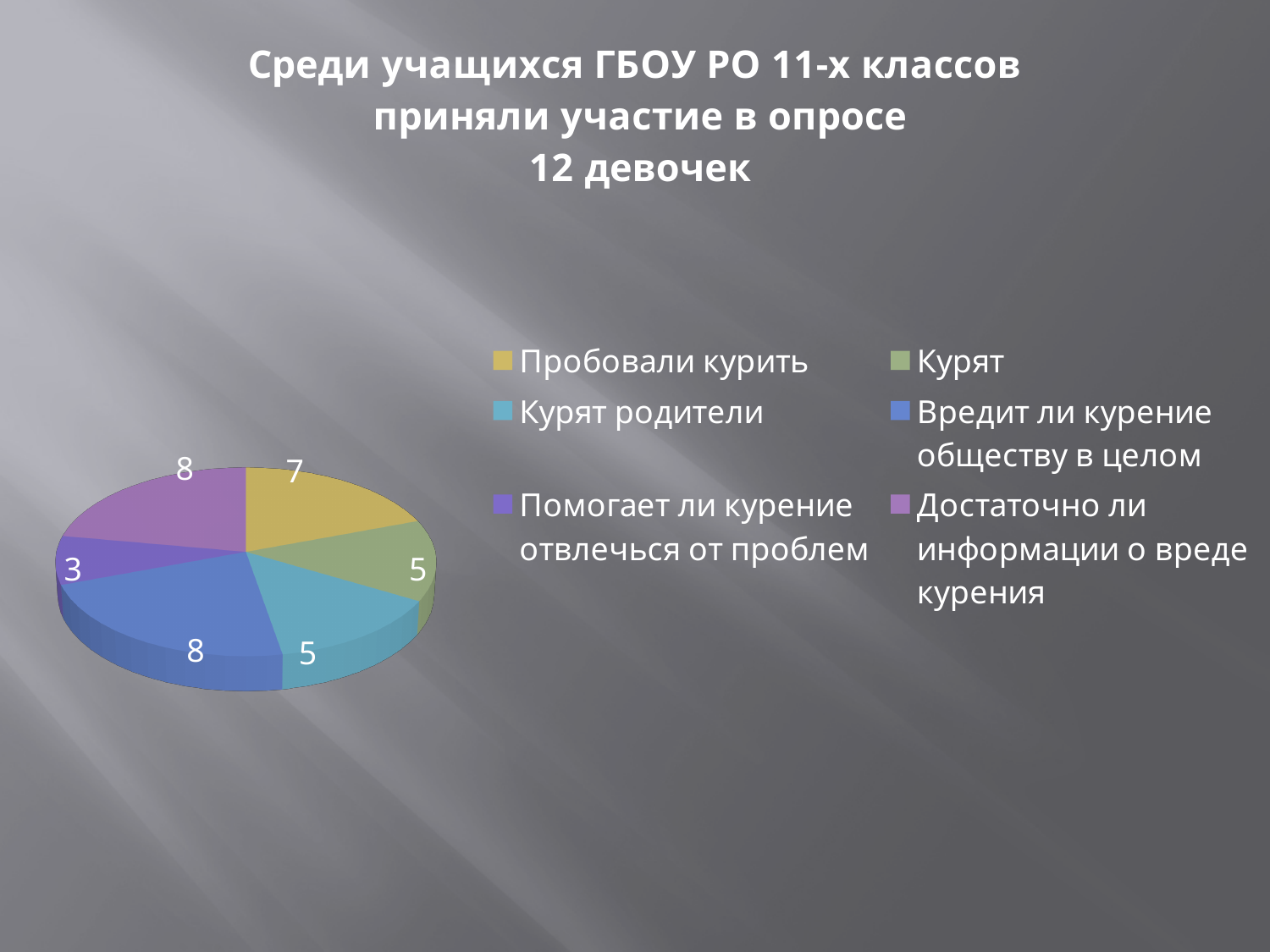
What colour is the slice for "Курят родители"? Cyan (light blue) What kind of chart is shown on the slide? Pie chart How many slices does the pie chart have? 6 What is the value for "Курят родители"? 5 What is the total of all the values shown in the pie chart? 36 What is the value for "Пробовали курить"? 7 What is the value for "Курят"? 5 What is the difference between the values for "Достаточно ли информации о вреде курения" and "Помогает ли курение отвлечься от проблем"? 5 What is the value for "Вредит ли курение обществу в целом"? 8 Which is larger: the value for "Пробовали курить" or the value for "Курят"? Пробовали курить What is the value for "Помогает ли курение отвлечься от проблем"? 3 Which category has the smallest slice in the pie chart? Помогает ли курение отвлечься от проблем